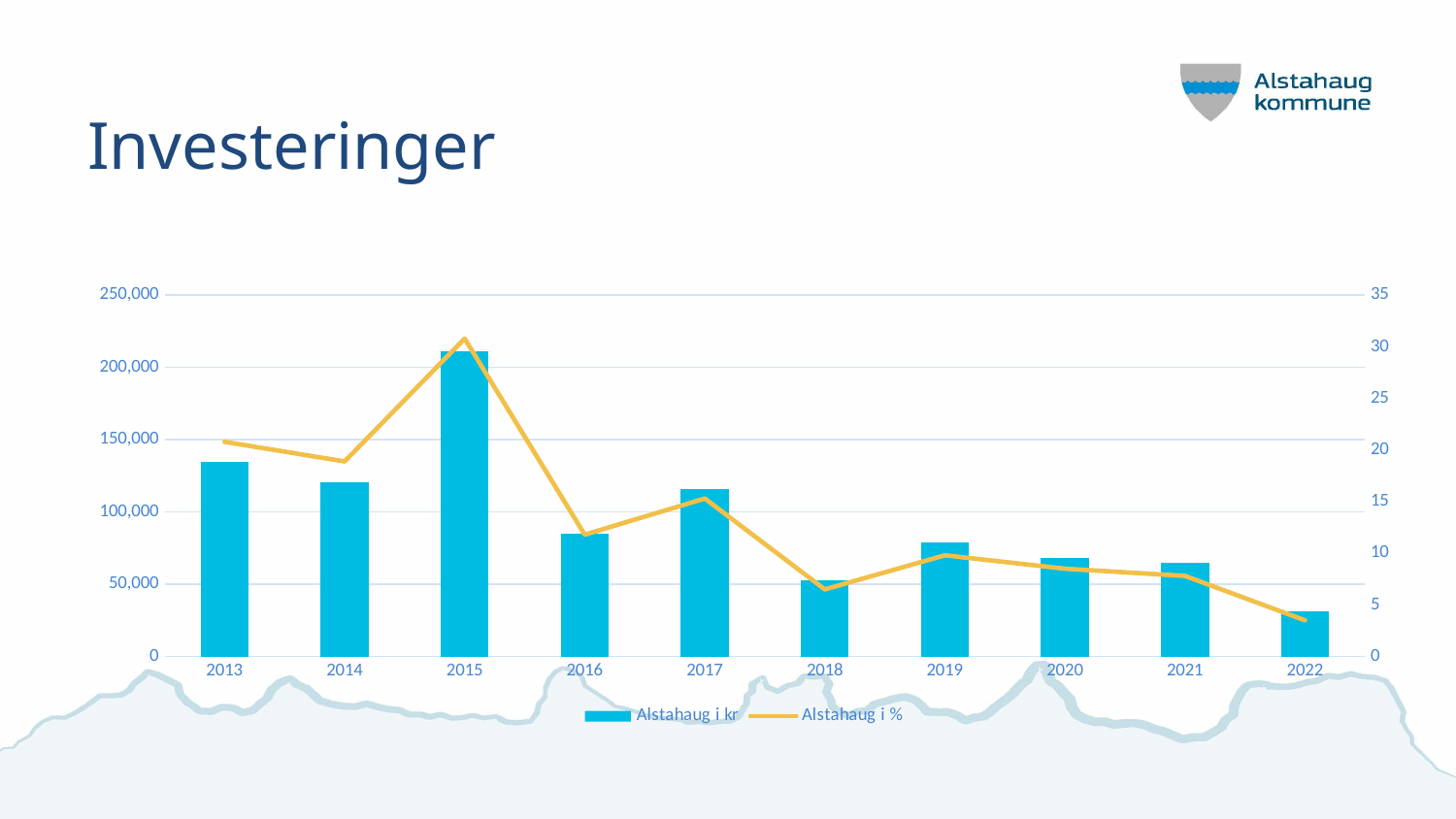
How many series does the legend list? 2 What is the title of the slide containing the chart? Investeringer What kind of chart is shown on the slide? Combined bar and line chart Which is larger for Alstahaug i kr, 2013 or 2014? 2013 Do the values for Alstahaug i kr rise or fall from 2019 to 2022? fall Which year has the lowest value for Alstahaug i kr? 2022 How many years are shown on the x axis? 10 Is the value for Alstahaug i % in 2022 greater or less than 5? less Which year has the highest value for Alstahaug i kr? 2015 Is the value for Alstahaug i kr in 2015 greater or less than 200,000? greater Is the value for Alstahaug i kr in 2022 greater or less than 50,000? less